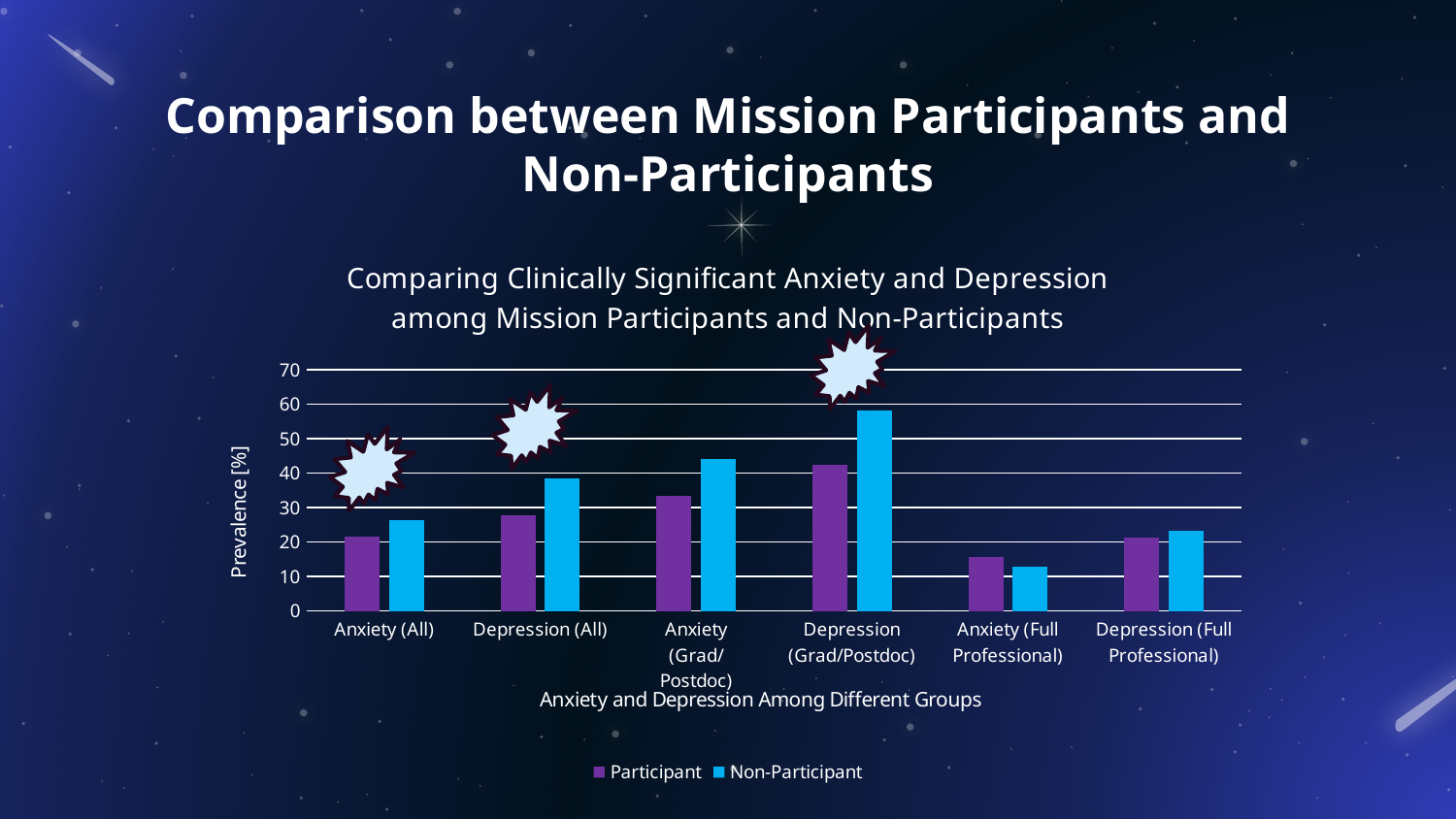
What kind of chart is shown on the slide? Bar chart Is the Non-Participant value for Depression (Grad/Postdoc) greater or less than 50? greater Is the Participant value for Anxiety (Full Professional) greater or less than 20? less How many groups are shown along the x axis of the chart? 6 For Anxiety (Grad/Postdoc), which is larger: the Participant or the Non-Participant value? Non-Participant For Depression (All), which is larger: the Participant or the Non-Participant value? Non-Participant Is the Non-Participant value for Anxiety (All) greater or less than 20? greater What is the label of the chart's vertical axis? Prevalence [%] Which group and series has the highest bar in the chart? Non-Participant, Depression (Grad/Postdoc) How many series does the chart legend list? 2 Among the Participant bars, which group has the lowest value? Anxiety (Full Professional)